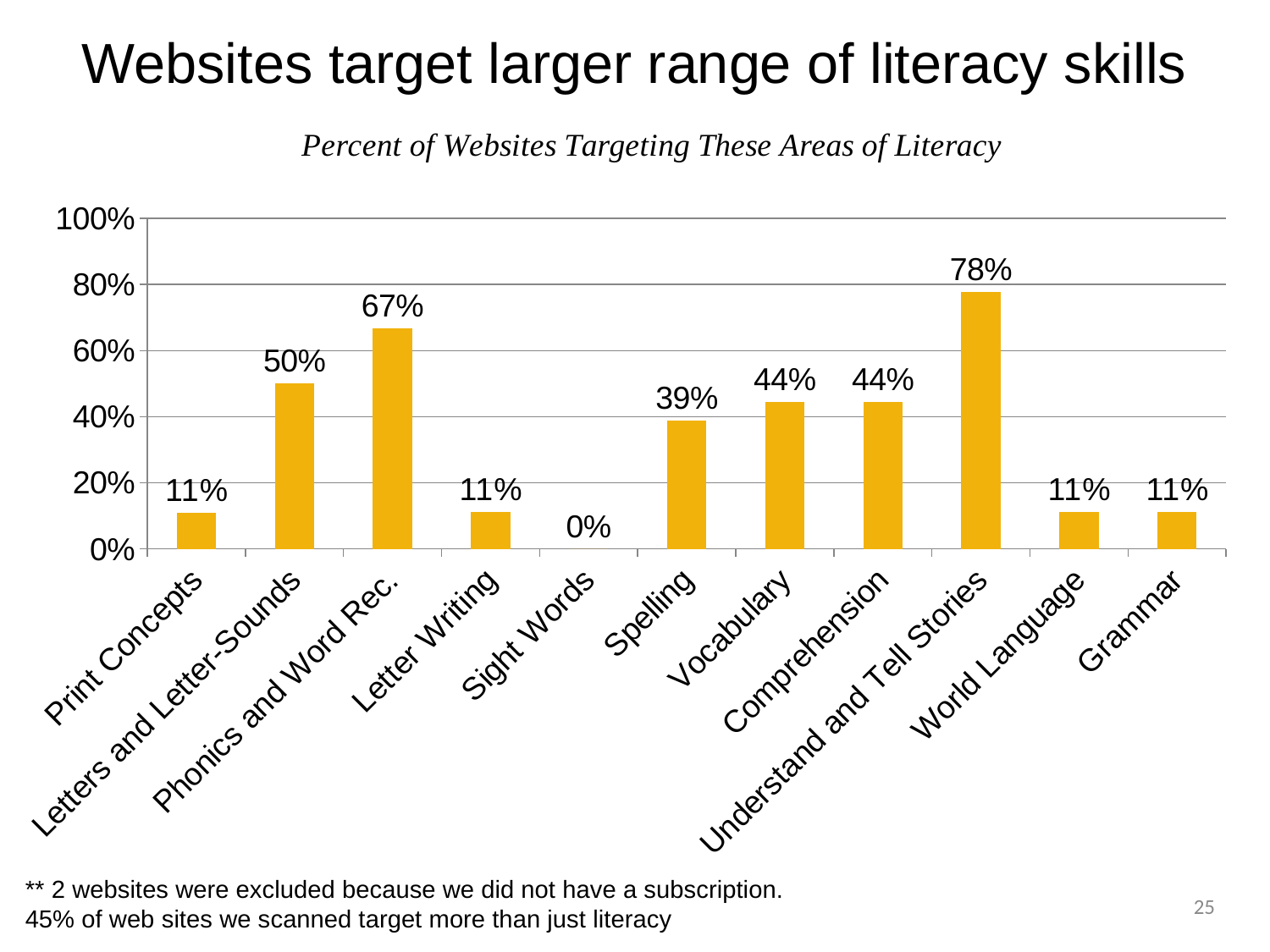
What is the difference between the values for Understand and Tell Stories and Letters and Letter-Sounds? 28% What percent of websites target Spelling? 39% How many literacy areas have a value of 11%? 4 Which literacy area has the lowest percent of websites targeting it? Sight Words Which is larger, the value for Vocabulary or the value for Spelling? Vocabulary What is the value for Sight Words? 0% Which literacy area has the highest percent of websites targeting it? Understand and Tell Stories What percent of websites target Phonics and Word Rec.? 67% Is the value for Phonics and Word Rec. greater or less than 60%? greater What kind of chart is shown on the slide? bar chart How many literacy areas are shown on the x axis? 11 What is the title of the chart? Percent of Websites Targeting These Areas of Literacy